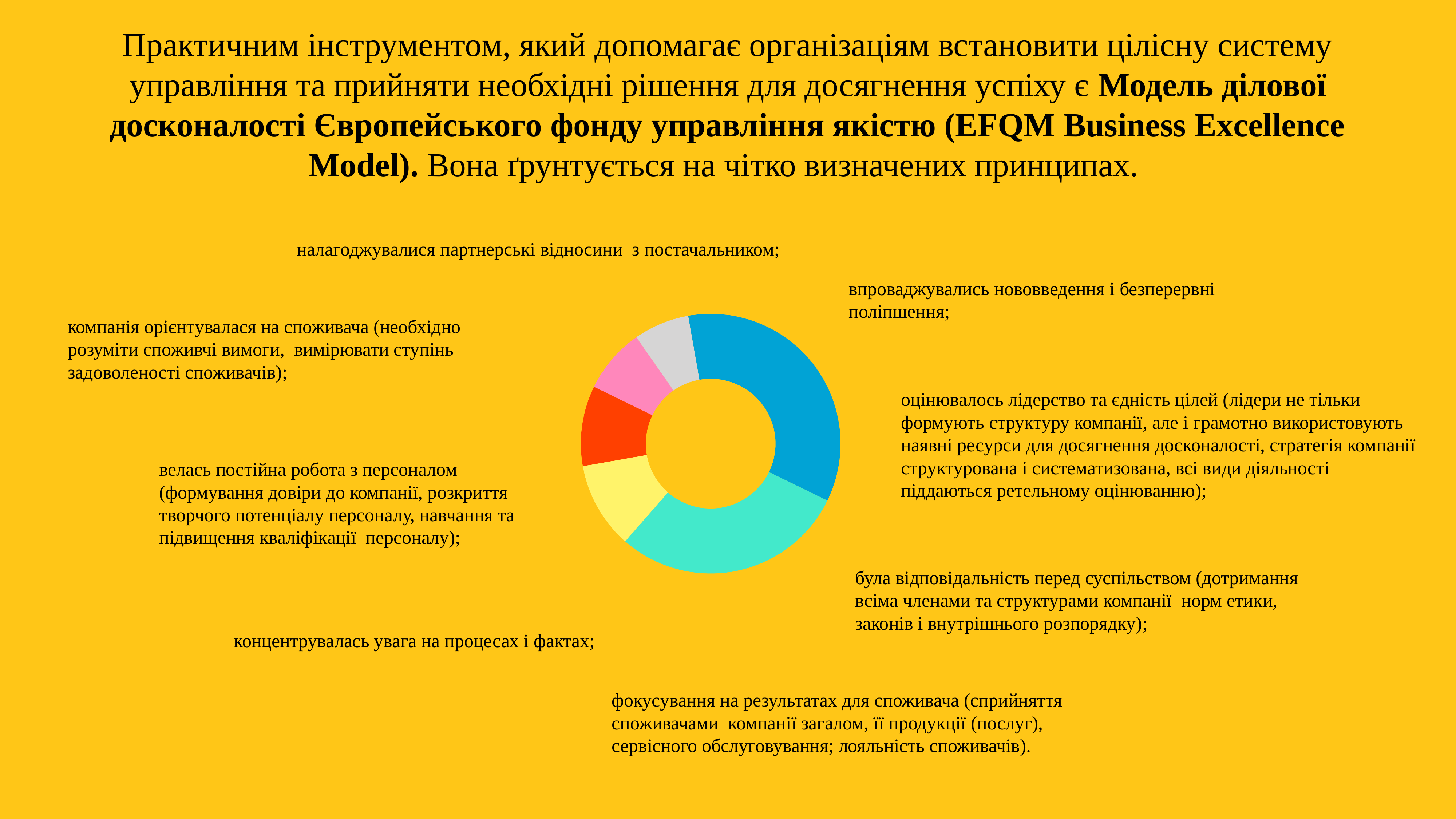
Does the doughnut chart show a legend? no Which is larger in the doughnut chart, the teal slice or the red slice? teal Which is larger in the doughnut chart, the blue slice or the grey slice? blue Which colour slice is the largest in the doughnut chart? blue Does the doughnut chart display data labels on its slices? no How many slices does the doughnut chart have? 6 What kind of chart is shown on the slide? doughnut chart Which is larger in the doughnut chart, the blue slice or the teal slice? blue